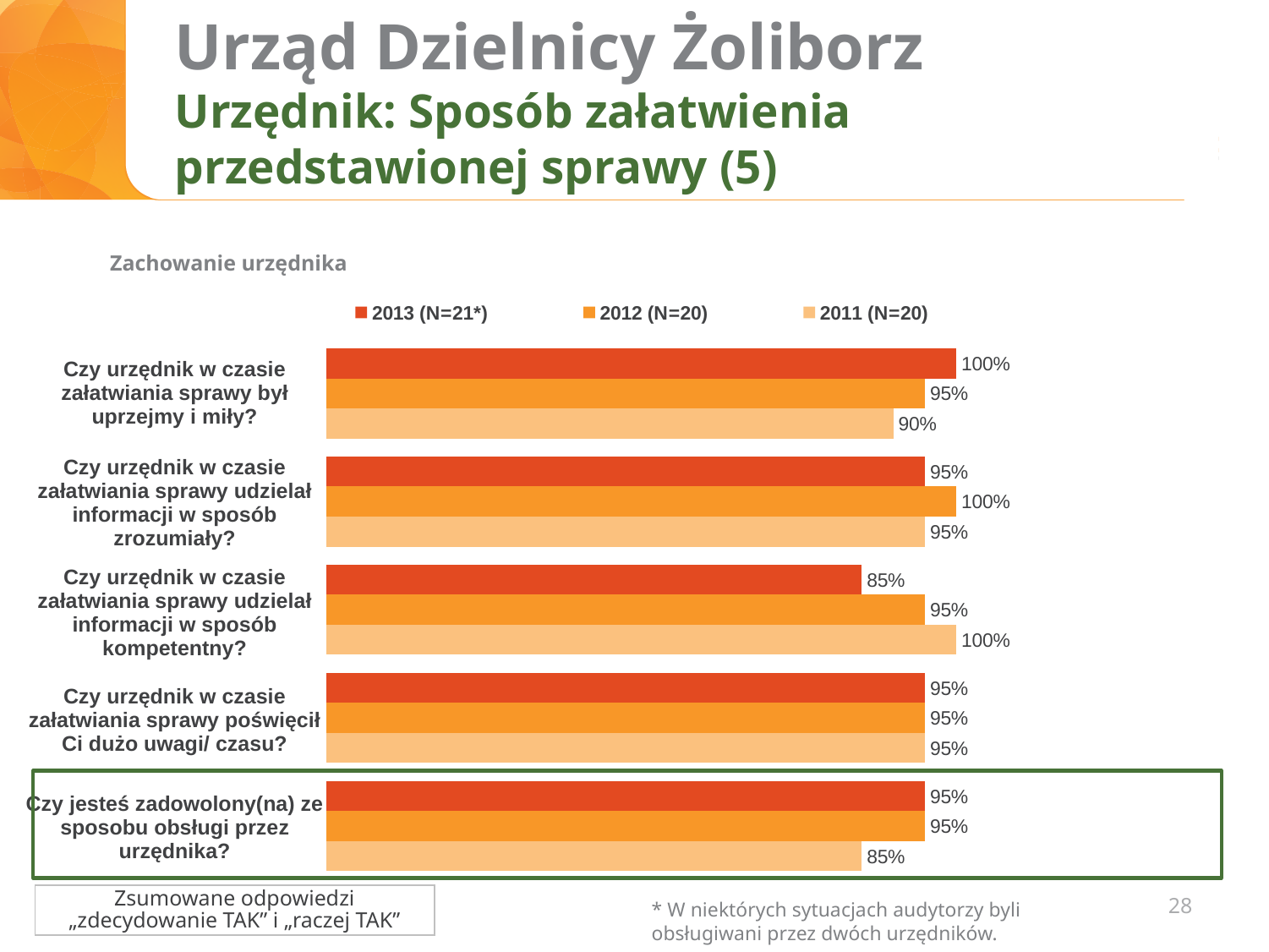
How many question categories are plotted in the chart? 5 Which year has the lowest value for "Czy urzędnik w czasie załatwiania sprawy udzielał informacji w sposób kompetentny?"? 2013 (N=21*) What is the subtitle shown above the chart? Zachowanie urzędnika How many series does the legend list? 3 What type of chart is shown on the slide? bar chart For "Czy urzędnik w czasie załatwiania sprawy był uprzejmy i miły?", which is larger: the 2013 value or the 2011 value? 2013 (N=21*) What is the 2013 (N=21*) value for "Czy urzędnik w czasie załatwiania sprawy udzielał informacji w sposób kompetentny?"? 85% What is the 2011 (N=20) value for "Czy urzędnik w czasie załatwiania sprawy był uprzejmy i miły?"? 90% What is the difference between the 2011 and 2013 values for "Czy urzędnik w czasie załatwiania sprawy udzielał informacji w sposób kompetentny?"? 15% What is the 2013 (N=21*) value for "Czy urzędnik w czasie załatwiania sprawy był uprzejmy i miły?"? 100% What is the 2011 (N=20) value for "Czy jesteś zadowolony(na) ze sposobu obsługi przez urzędnika?"? 85% Which year has the highest value for "Czy urzędnik w czasie załatwiania sprawy udzielał informacji w sposób zrozumiały?"? 2012 (N=20)